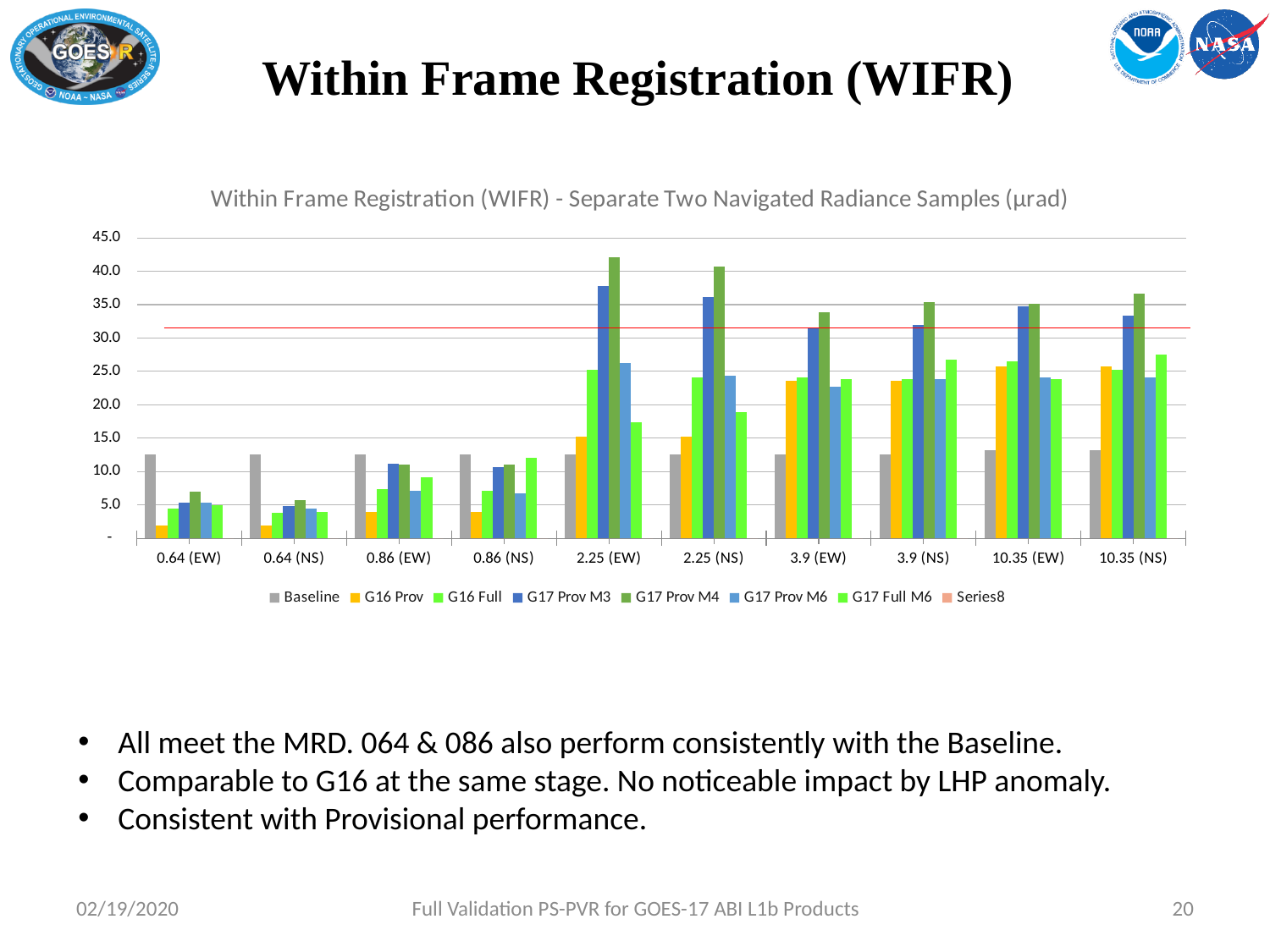
Which category contains the tallest bar in the chart? 2.25 (EW) Is the value for G17 Full M6 at 10.35 (NS) greater or less than 25.0? greater At 2.25 (EW), which is larger: G17 Prov M4 or G17 Prov M6? G17 Prov M4 At 0.64 (EW), which is larger: Baseline or G16 Prov? Baseline Is the value for G17 Prov M4 at 2.25 (EW) greater or less than 40.0? greater Is the value for G17 Prov M3 at 2.25 (NS) greater or less than 35.0? greater How many categories are shown along the x axis of the chart? 10 How many series does the chart's legend list? 8 What kind of chart is shown on the slide? Bar chart What is the title of the chart? Within Frame Registration (WIFR) - Separate Two Navigated Radiance Samples (μrad)